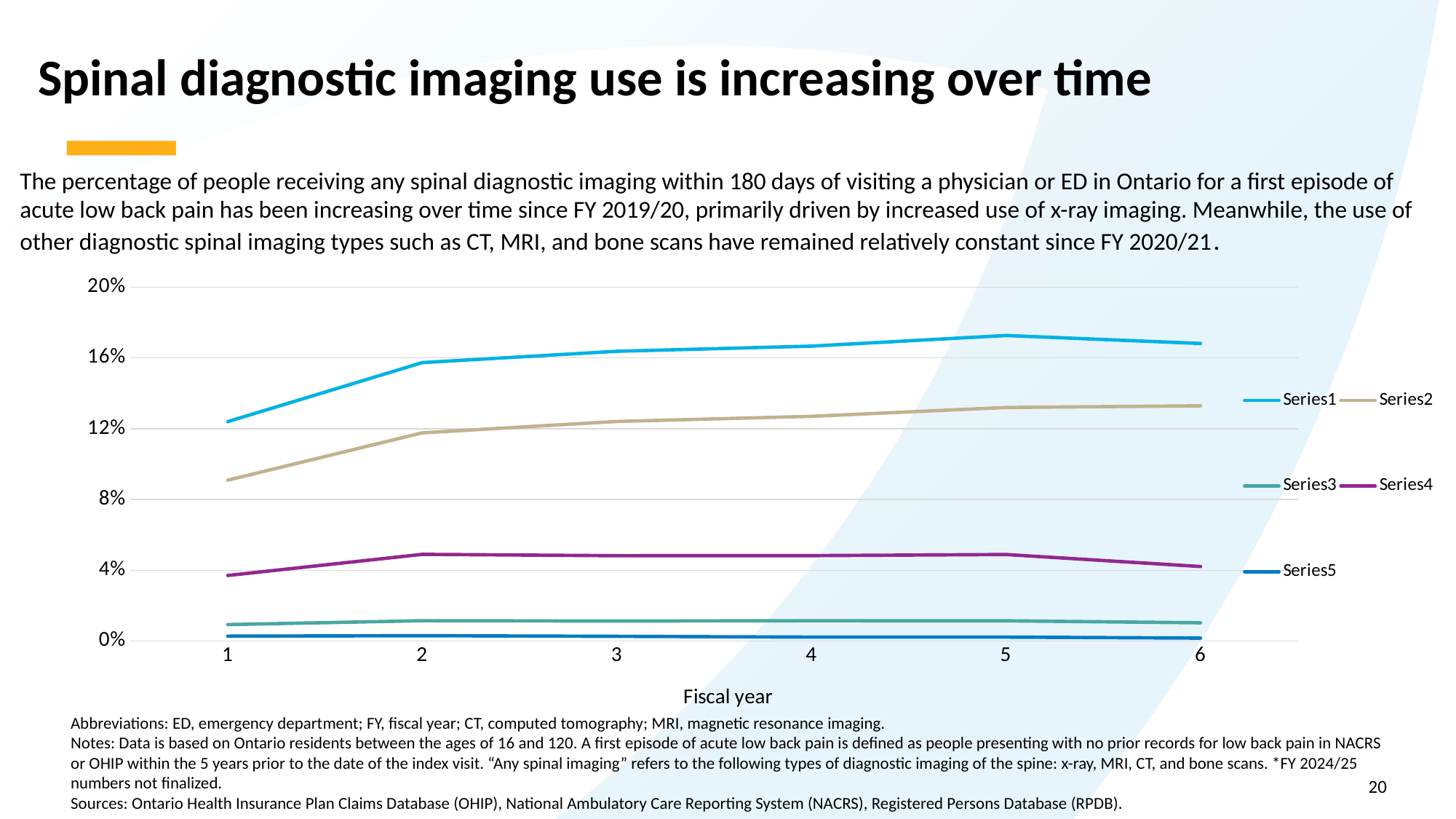
At which fiscal year is Series2 at its lowest value? 1 At which fiscal year does Series1 reach its highest value? 5 Is the value for Series1 at fiscal year 5 greater or less than 16%? greater Which series has the lowest values across all fiscal years? Series5 What kind of chart is shown on the slide? line chart Which series has the highest values across all fiscal years? Series1 Is the value for Series2 at fiscal year 1 greater or less than 8%? greater Is the value for Series3 at fiscal year 4 greater or less than 4%? less Which is larger at fiscal year 3, Series1 or Series2? Series1 Does Series2 rise or fall from fiscal year 1 to fiscal year 6? rise How many fiscal year points are plotted along the x axis? 6 How many series does the legend list? 5